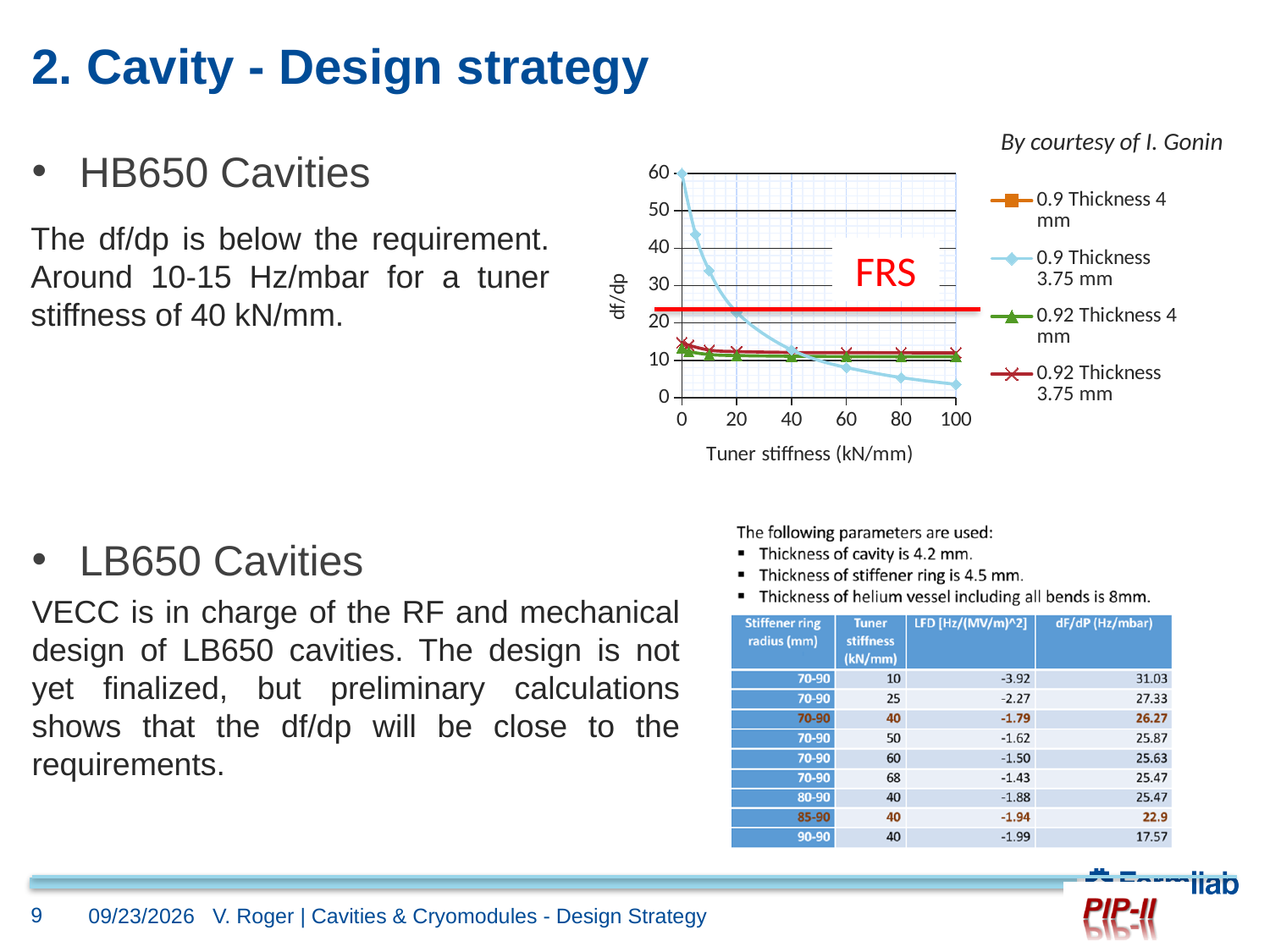
How many series does the chart legend list? 4 Does the value for the 0.9 Thickness 3.75 mm series rise or fall as tuner stiffness increases? fall What is the highest tick value shown on the x axis of the chart? 100 Is the value for the 0.9 Thickness 3.75 mm series at a tuner stiffness of 100 greater or less than 10? less At a tuner stiffness of 0, which series has the larger value: 0.9 Thickness 3.75 mm or 0.92 Thickness 3.75 mm? 0.9 Thickness 3.75 mm Is the value for the 0.92 Thickness 3.75 mm series at a tuner stiffness of 100 greater or less than 20? less What kind of chart is shown on the slide? line chart What is the label of the x axis of the chart? Tuner stiffness (kN/mm) What is the label of the y axis of the chart? df/dp Is the value for the 0.9 Thickness 3.75 mm series at a tuner stiffness of 0 greater or less than 50? greater At a tuner stiffness of 100, which series has the smaller value: 0.9 Thickness 3.75 mm or 0.92 Thickness 4 mm? 0.9 Thickness 3.75 mm